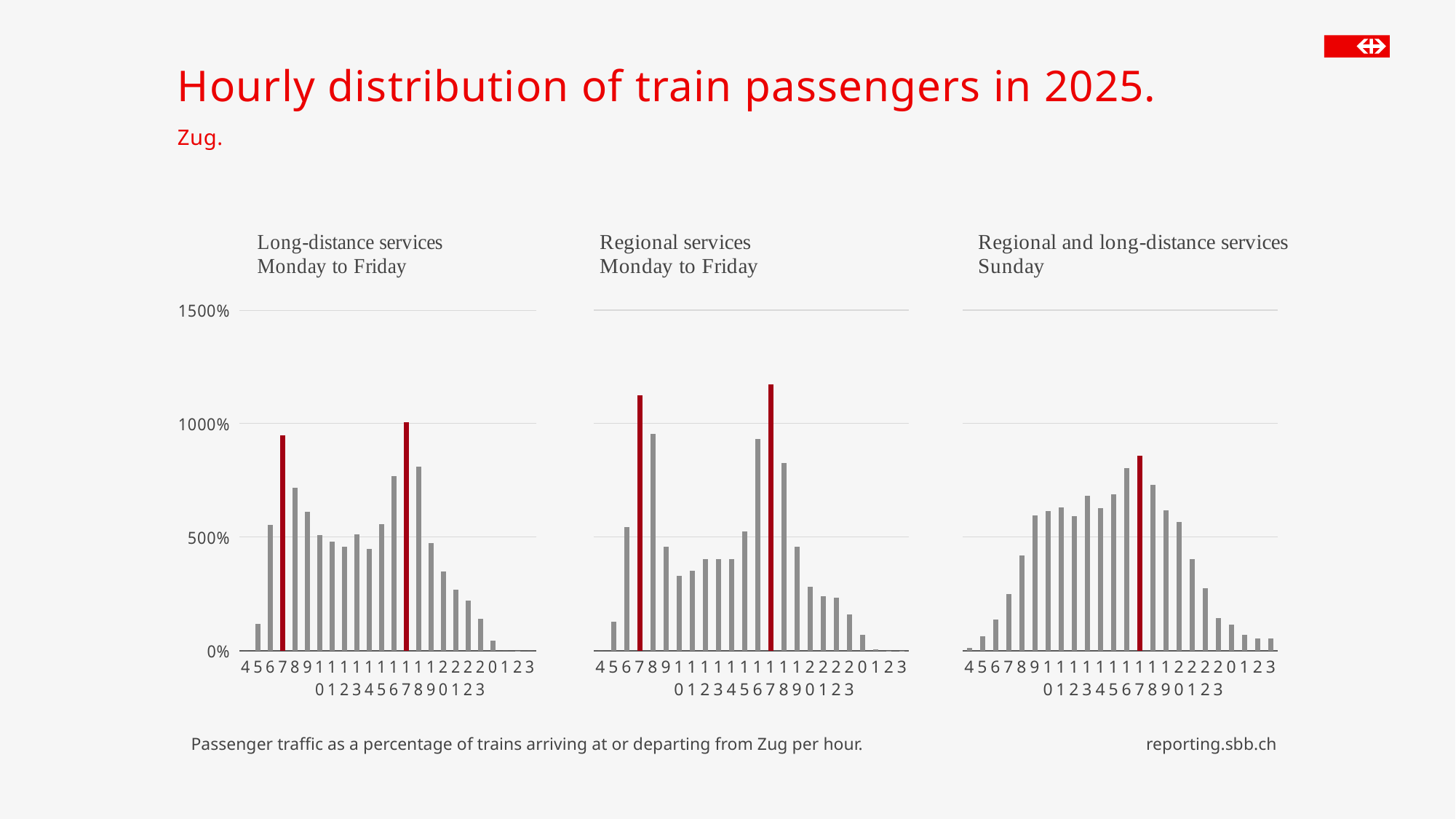
What kind of chart is the 'Long-distance services Monday to Friday' chart? bar chart In the 'Long-distance services Monday to Friday' chart, is the value for hour 23 greater or less than 500%? less In the 'Regional and long-distance services Sunday' chart, which hour has the highest value? 17 How many hourly categories are shown on the x axis of the 'Regional services Monday to Friday' chart? 24 In the 'Long-distance services Monday to Friday' chart, which hours are highlighted with red bars? 7 and 17 In the 'Regional services Monday to Friday' chart, which is larger, the value for hour 8 or hour 9? hour 8 In the 'Regional and long-distance services Sunday' chart, is the value for hour 17 greater or less than 1000%? less In the 'Long-distance services Monday to Friday' chart, which is larger, the value for hour 8 or hour 9? hour 8 In the 'Long-distance services Monday to Friday' chart, is the value for hour 7 greater or less than 500%? greater In the 'Regional and long-distance services Sunday' chart, do the values rise or fall from hour 17 to hour 23? fall What is the title of the slide? Hourly distribution of train passengers in 2025.